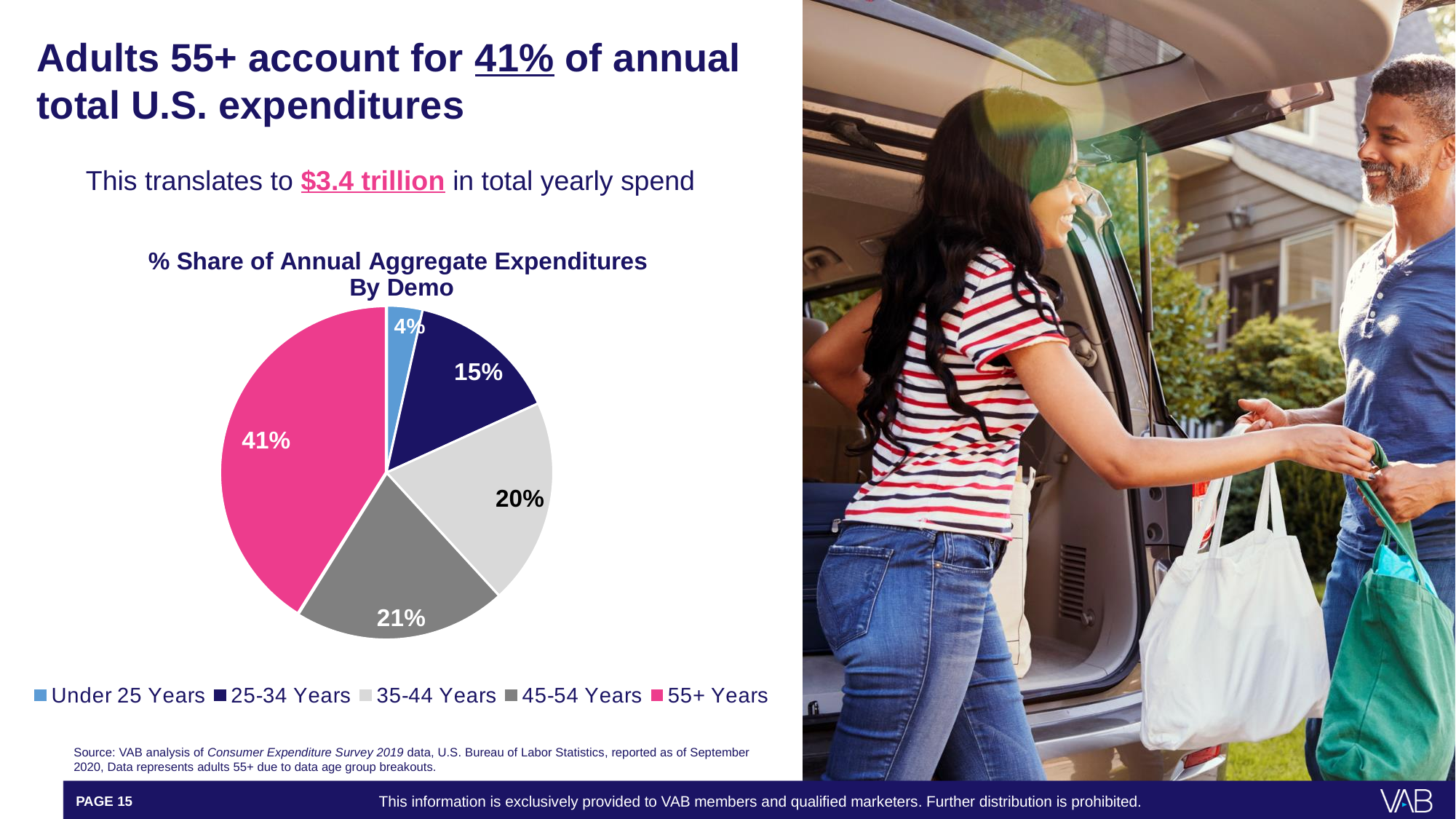
Which age group has the smallest share of annual aggregate expenditures? Under 25 Years How many age groups are shown in the pie chart? 5 What colour is the slice representing 55+ Years? pink Which group has a larger share of expenditures, 25-34 Years or 45-54 Years? 45-54 Years What share of annual aggregate expenditures is attributed to the 35-44 Years group? 20% How many percentage points larger is the 55+ Years share than the 45-54 Years share? 20 What share of annual aggregate expenditures is attributed to the Under 25 Years group? 4% What share of annual aggregate expenditures is attributed to adults 55+ Years? 41% What is the title of the pie chart? % Share of Annual Aggregate Expenditures By Demo Which age group has the largest share of annual aggregate expenditures? 55+ Years What type of chart is shown on the slide? pie chart What share of annual aggregate expenditures is attributed to the 25-34 Years group? 15%